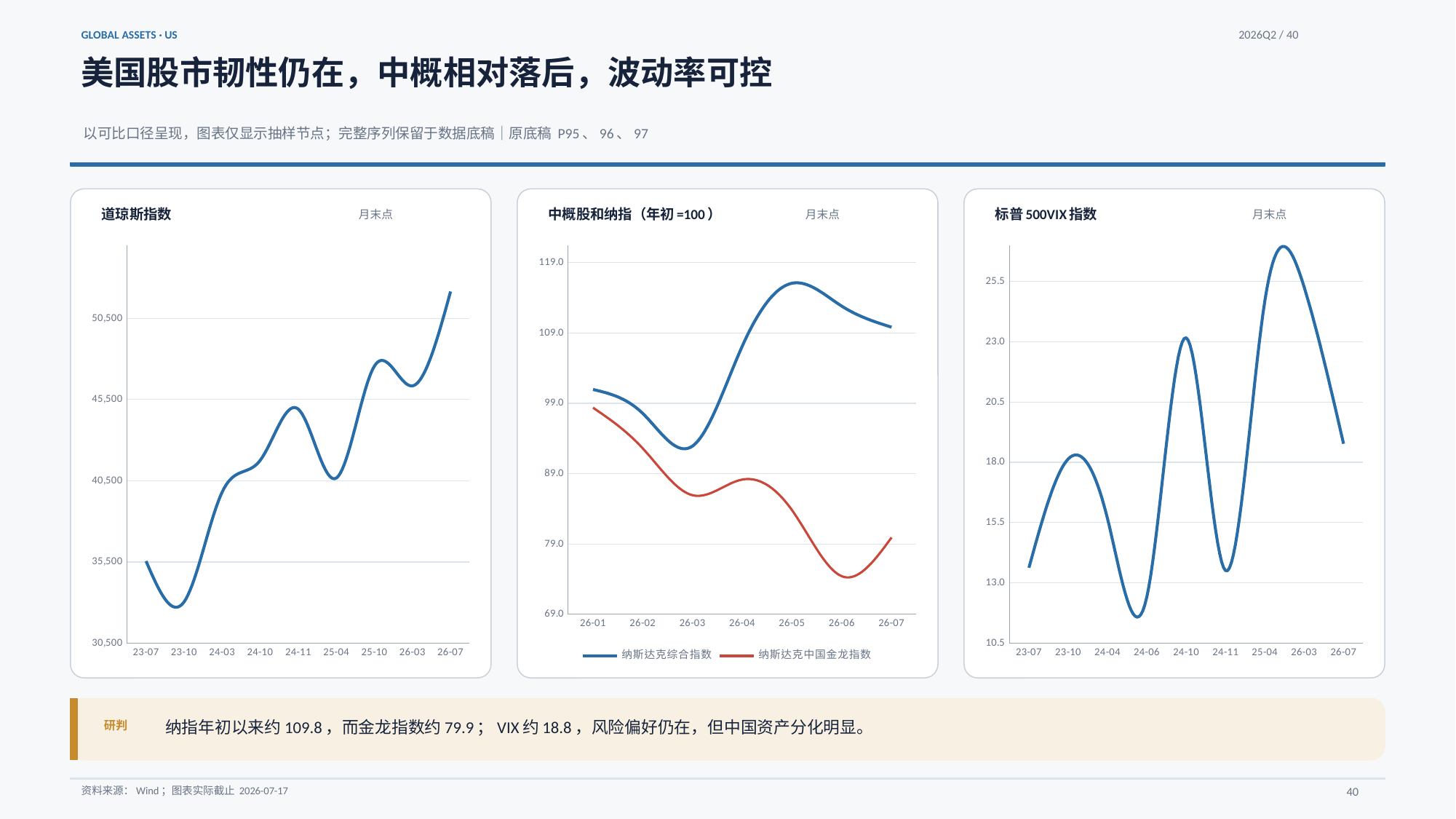
On the 标普500VIX指数 chart, at which x-axis point is the value highest? 26-03 On the 道琼斯指数 chart, at which x-axis point is the value highest? 26-07 On the 中概股和纳指（年初=100） chart, at which x-axis point does 纳斯达克综合指数 reach its highest value? 26-05 On the 标普500VIX指数 chart, is the value at 26-07 greater or less than 20.5? less On the 道琼斯指数 chart, is the value at 26-07 greater or less than 50,500? greater On the 中概股和纳指（年初=100） chart, which series is higher at 26-07? 纳斯达克综合指数 How many series does the legend of the 中概股和纳指（年初=100） chart list? 2 On the 中概股和纳指（年初=100） chart, is the 纳斯达克中国金龙指数 value at 26-06 greater or less than 79.0? less How many x-axis points are shown on the 道琼斯指数 chart? 9 What kind of chart is the 道琼斯指数 chart? Line chart On the 道琼斯指数 chart, do values overall rise or fall from 23-07 to 26-07? rise On the 道琼斯指数 chart, at which x-axis point is the value lowest? 23-10